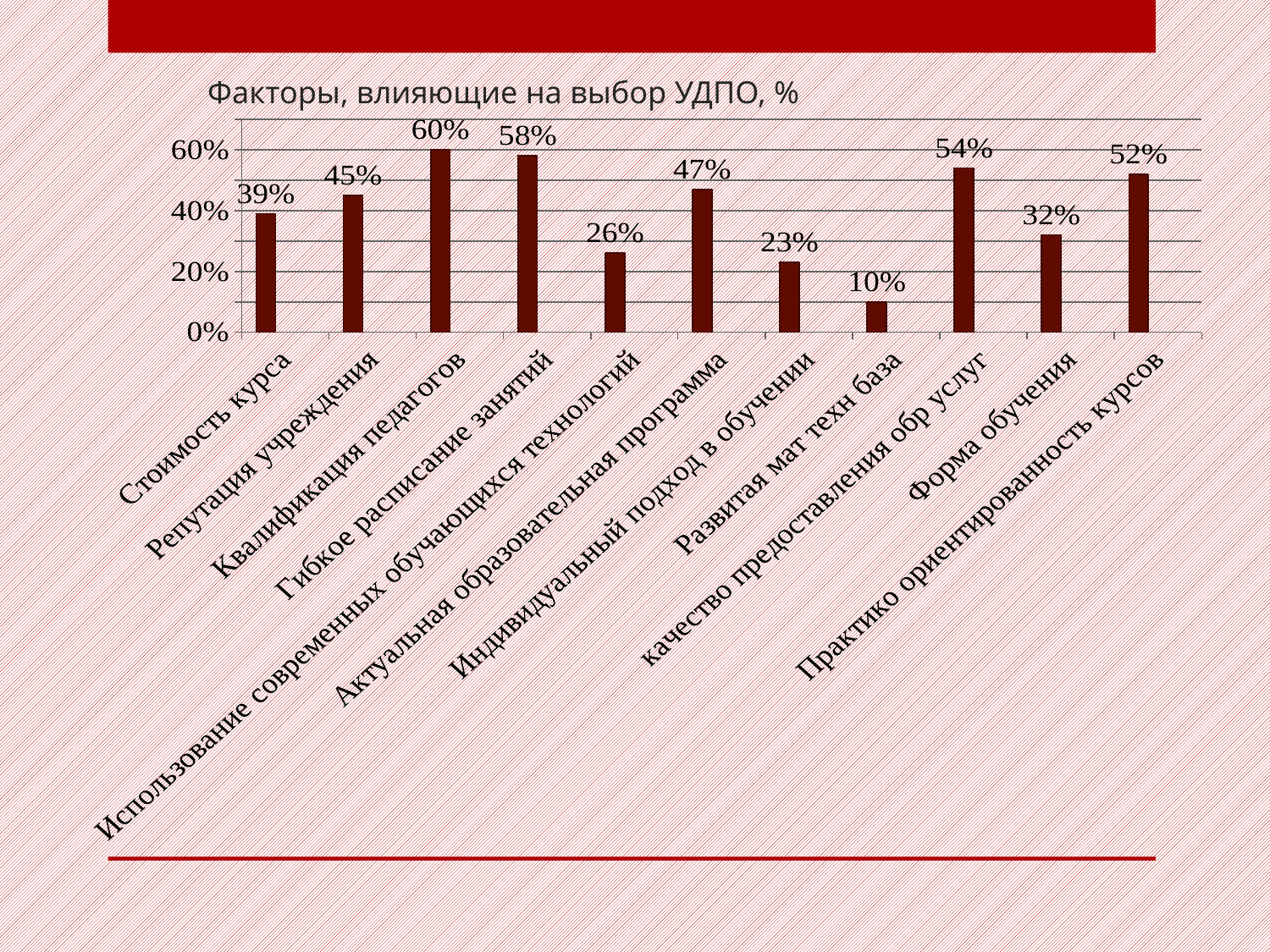
What is the value for Стоимость курса? 39% Which is larger, the value for Репутация учреждения or the value for Актуальная образовательная программа? Актуальная образовательная программа Which category has the highest value? Квалификация педагогов How many categories are shown in the chart? 11 What is the value for качество предоставления обр услуг? 54% What is the value for Развитая мат техн база? 10% What is the value for Квалификация педагогов? 60% What is the difference between the values for Гибкое расписание занятий and Форма обучения? 26% What is the title of the chart? Факторы, влияющие на выбор УДПО, % Which category has the lowest value? Развитая мат техн база Is the value for Индивидуальный подход в обучении greater or less than 40%? less What kind of chart is shown on the slide? bar chart